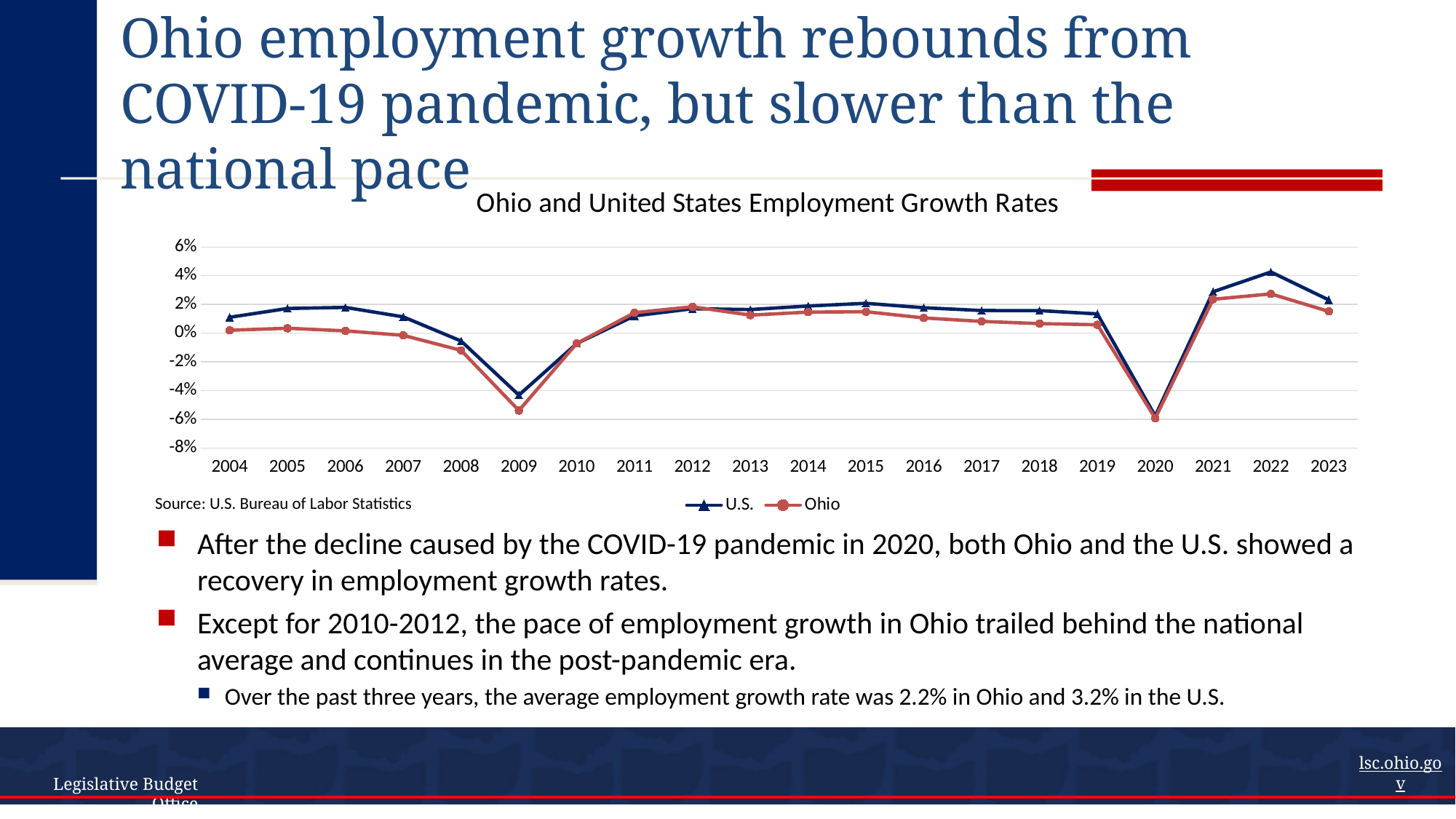
In which year is the U.S. employment growth rate highest? 2022 What kind of chart is shown on the slide? Line chart Which series has the larger value in 2008, U.S. or Ohio? U.S. Is the U.S. value for 2021 greater or less than 2%? greater How many years are plotted along the x axis? 20 How many series does the legend list? 2 Is the Ohio value for 2020 greater or less than -4%? less In which year is the U.S. employment growth rate lowest? 2020 What is the title of the chart? Ohio and United States Employment Growth Rates In which year is the Ohio employment growth rate highest? 2022 Do the Ohio values rise or fall from 2009 to 2012? Rise Which series has the larger value in 2019, U.S. or Ohio? U.S.